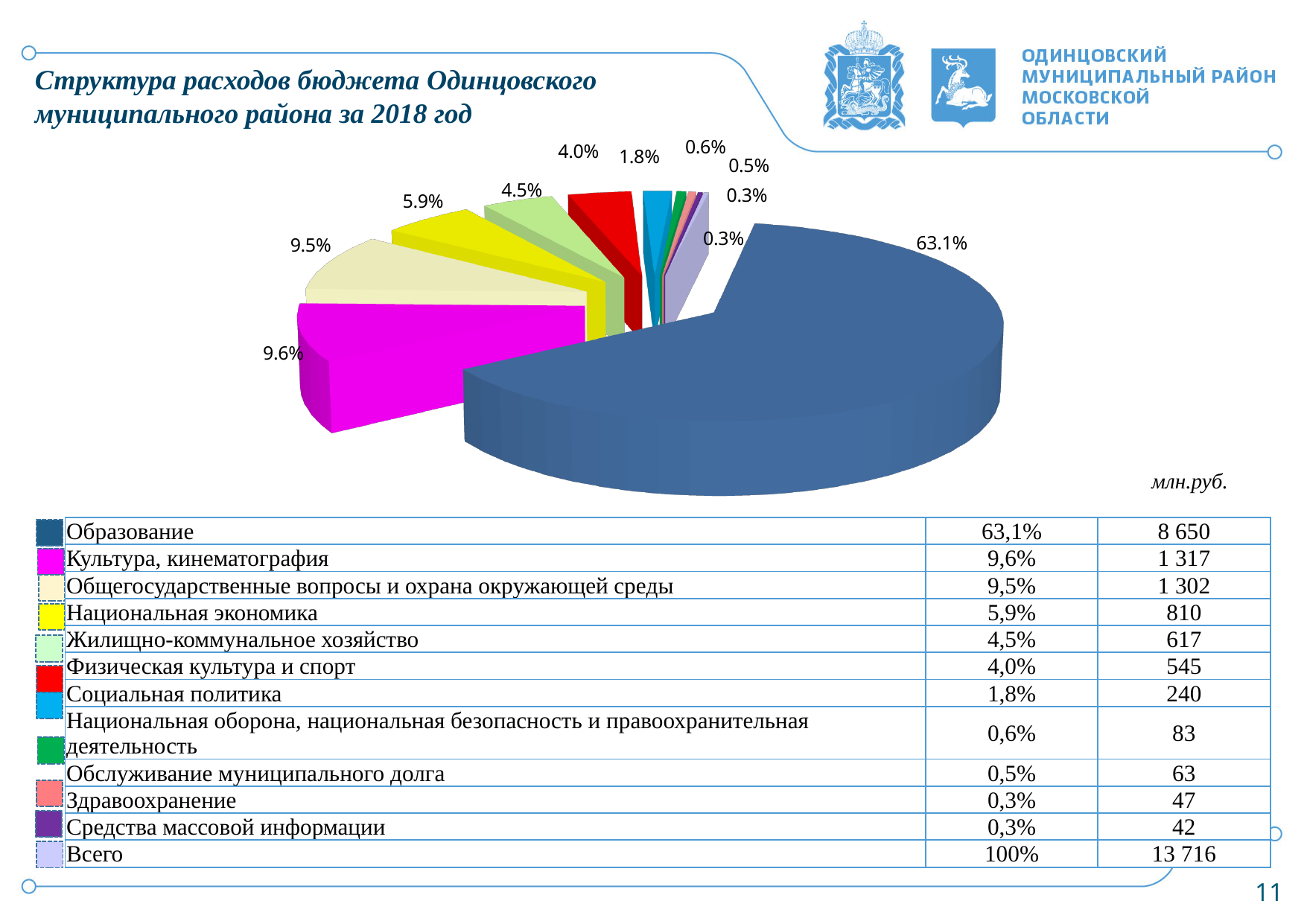
What share of the pie does Культура, кинематография have? 9.6% Which has the larger share: Общегосударственные вопросы и охрана окружающей среды or Национальная экономика? Общегосударственные вопросы и охрана окружающей среды How many slices does the pie chart have? 11 What share of the pie does Социальная политика have? 1.8% Which category has the largest share of the pie chart? Образование What share of the pie does Образование have? 63.1% What share of the pie does Национальная экономика have? 5.9% In what unit are the amounts in the table below the pie chart given? млн.руб. What share of the pie does Физическая культура и спорт have? 4.0% What is the difference in percentage points between the shares of Образование and Культура, кинематография? 53.5 percentage points What is the title of the slide containing the pie chart? Структура расходов бюджета Одинцовского муниципального района за 2018 год What kind of chart is shown on the slide? pie chart